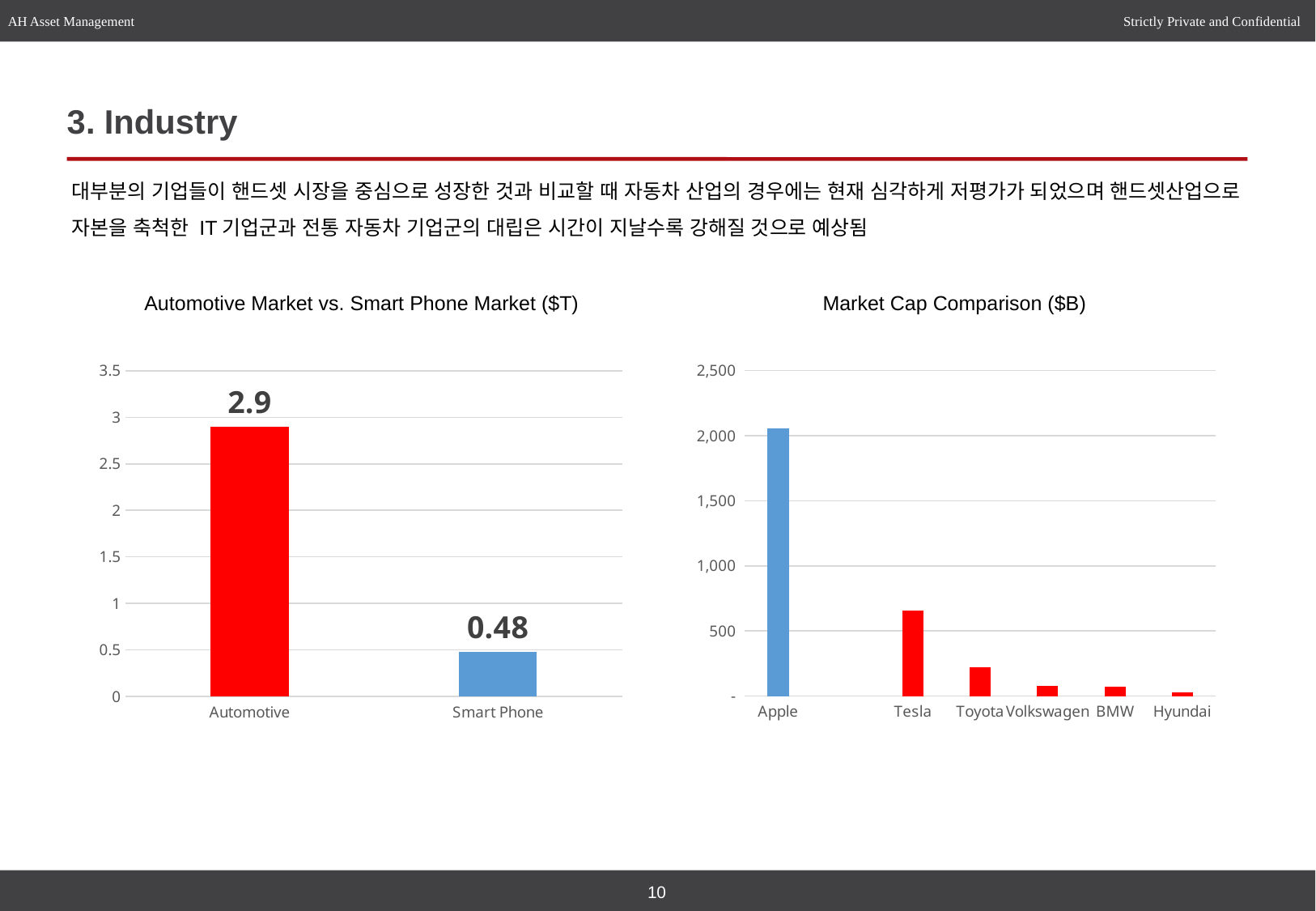
In the 'Market Cap Comparison ($B)' chart, which company has the highest market cap? Apple In the 'Market Cap Comparison ($B)' chart, is the value for Tesla greater or less than 1,000? less In the 'Automotive Market vs. Smart Phone Market ($T)' chart, which category has the higher value? Automotive In the 'Market Cap Comparison ($B)' chart, which company has the lowest market cap? Hyundai In the 'Market Cap Comparison ($B)' chart, is the value for Apple greater or less than 1,500? greater How many companies are shown in the 'Market Cap Comparison ($B)' chart? 6 In the 'Automotive Market vs. Smart Phone Market ($T)' chart, what is the difference between the Automotive and Smart Phone values? 2.42 What kind of chart is the 'Market Cap Comparison ($B)' chart? Bar chart How many categories are shown in the 'Automotive Market vs. Smart Phone Market ($T)' chart? 2 In the 'Automotive Market vs. Smart Phone Market ($T)' chart, what is the value for Automotive? 2.9 In the 'Automotive Market vs. Smart Phone Market ($T)' chart, what is the value for Smart Phone? 0.48 In the 'Market Cap Comparison ($B)' chart, which is larger, the value for Tesla or the value for Toyota? Tesla